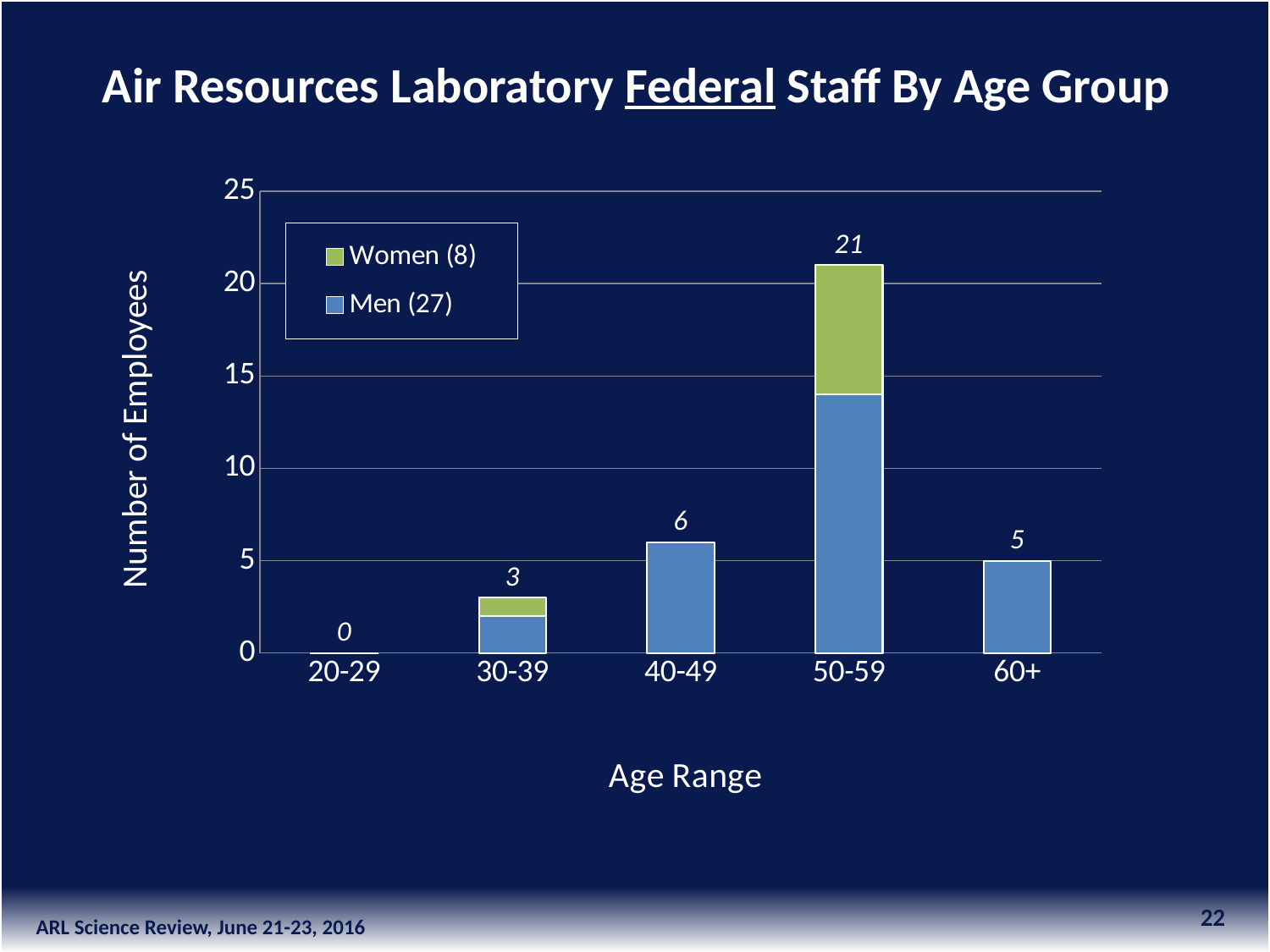
What is the difference between the total employees in the 50-59 and 40-49 age ranges? 15 How many series does the legend list? 2 Which age range has more employees, 40-49 or 60+? 40-49 What type of chart is shown on the slide? Stacked bar chart What is the total number of employees in the 30-39 age range? 3 What is the total number of employees in the 50-59 age range? 21 Is the number of men in the 50-59 age range greater or less than 10? greater What is the total number of employees in the 40-49 age range? 6 Which age range has the highest number of employees? 50-59 How many age ranges are shown on the x axis? 5 Which age range has the lowest number of employees? 20-29